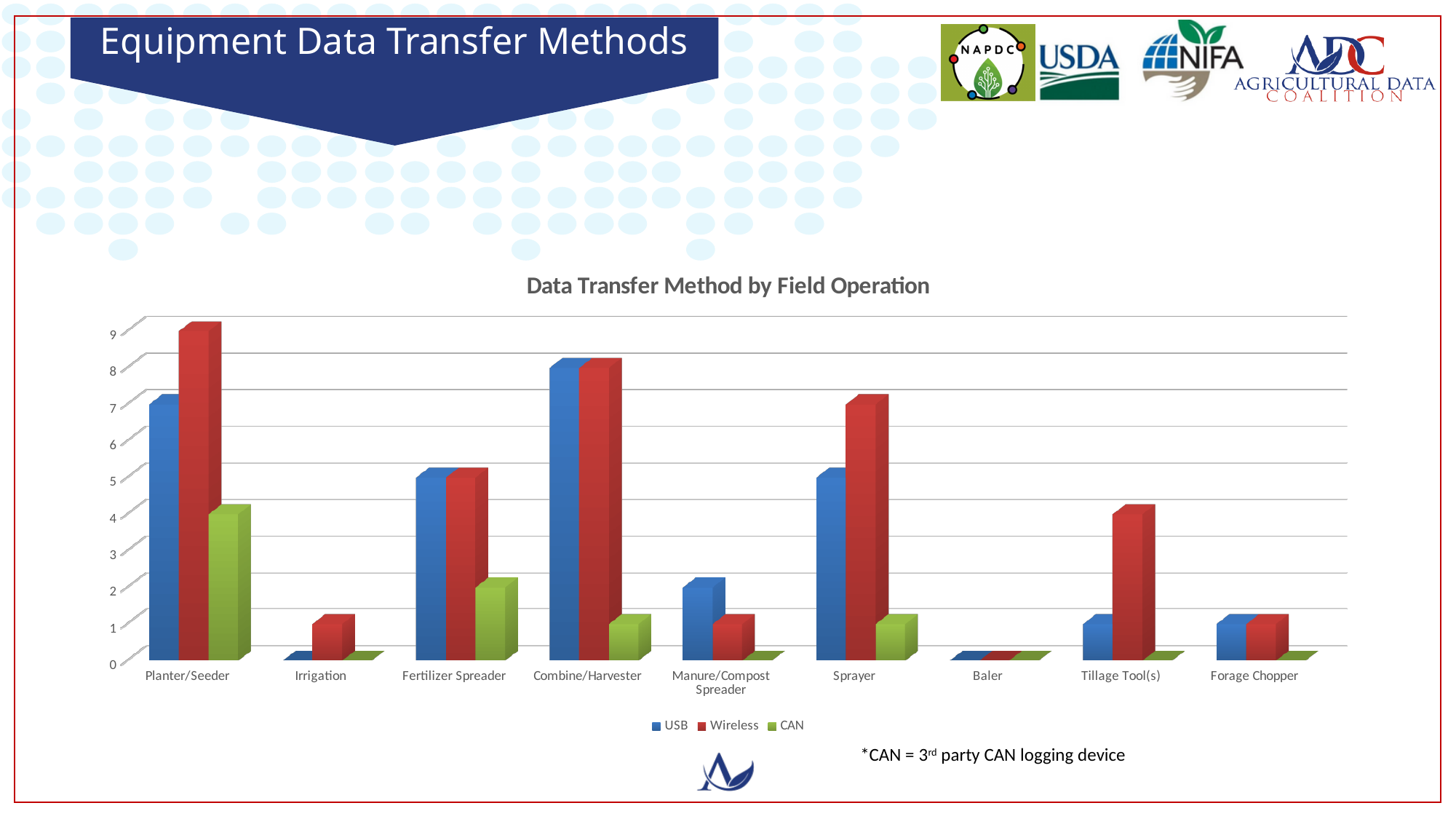
What kind of chart is shown on the slide? bar chart What is the title of the chart? Data Transfer Method by Field Operation Which colour represents the CAN series in the chart? green Is the Wireless value for Planter/Seeder greater or less than 8? greater Which field operation has the highest USB value? Combine/Harvester Is the USB value for Manure/Compost Spreader greater or less than 4? less For Tillage Tool(s), which is larger, the USB value or the Wireless value? Wireless For Sprayer, which is larger, the USB value or the Wireless value? Wireless How many field operation categories are shown on the x axis? 9 How many series does the legend list? 3 Which field operation has the highest Wireless value? Planter/Seeder Which field operation has the highest CAN value? Planter/Seeder